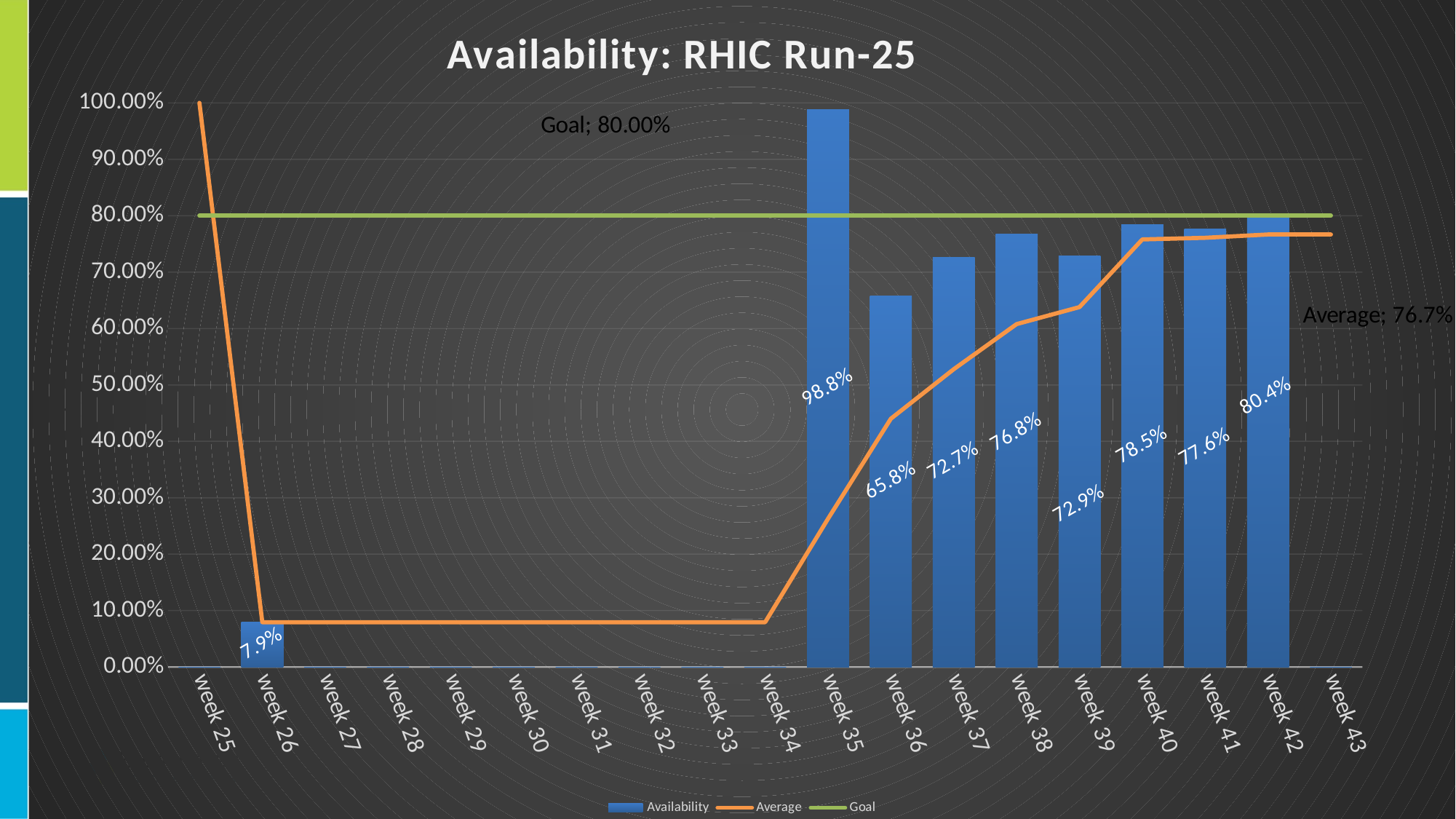
What is the Availability value for week 42? 80.4% What is the difference between the Availability values for week 40 and week 41? 0.9 percentage points What is the Availability value for week 26? 7.9% Which has the larger Availability value, week 38 or week 39? week 38 What is the Availability value for week 35? 98.8% Which week has the highest Availability bar? week 35 How many series does the legend list? 3 How many week categories are shown on the x axis? 19 What kind of chart is used to show the Availability series? bar chart What is the difference between the Availability values for week 35 and week 36? 33.0 percentage points What value is the Goal line set at? 80.00% Is the Availability value for week 36 greater or less than 70.00%? less